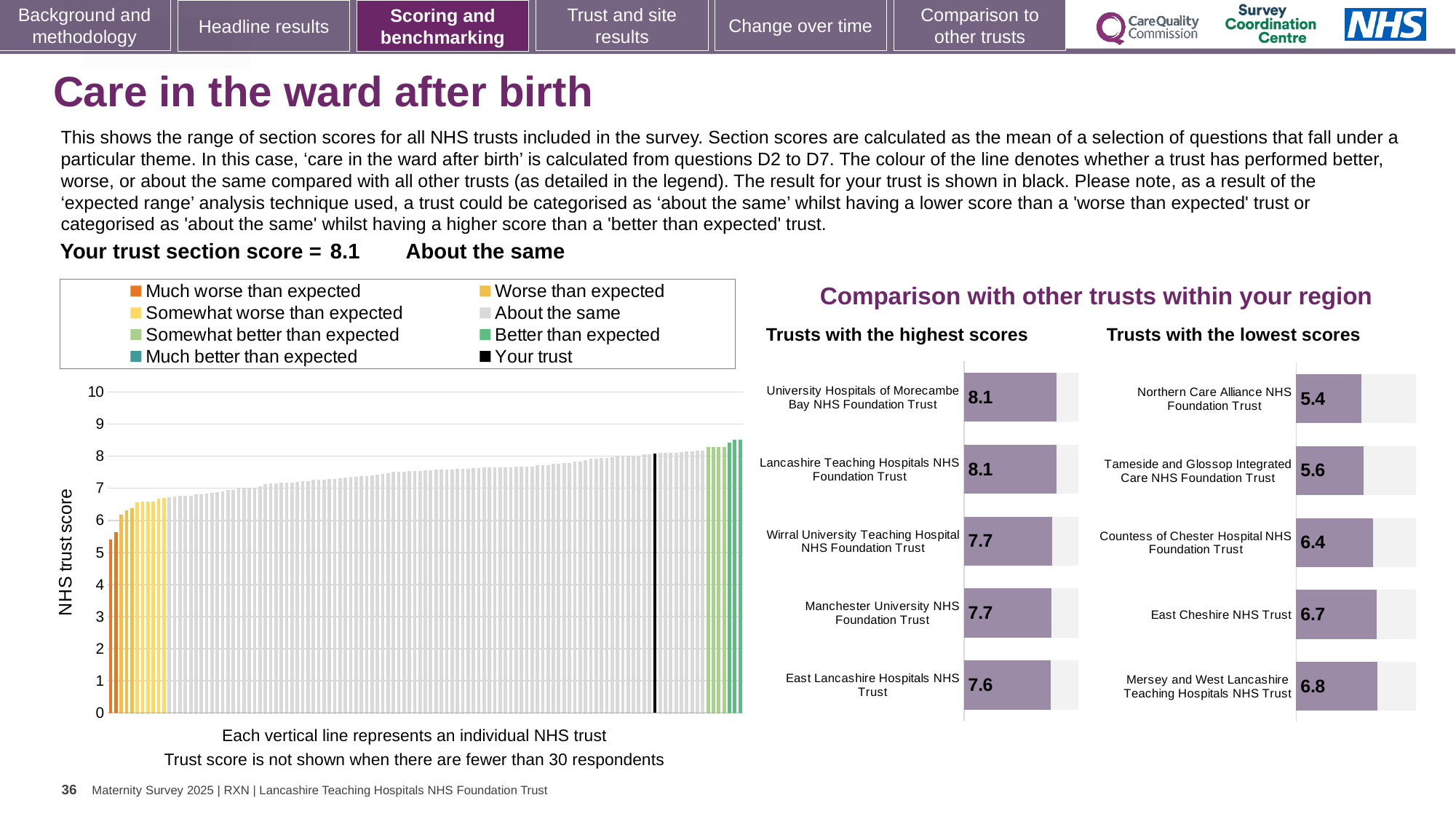
How many trusts are shown in the 'Trusts with the highest scores' chart? 5 In the 'Trusts with the highest scores' chart, what is the score for Wirral University Teaching Hospital NHS Foundation Trust? 7.7 In the 'Trusts with the lowest scores' chart, which trust has the lowest score? Northern Care Alliance NHS Foundation Trust In the main NHS trust score chart, is the value for the black 'Your trust' bar greater or less than 7? greater How many entries does the legend of the main NHS trust score chart list? 8 What is the y-axis label of the main chart on the left? NHS trust score In the 'Trusts with the lowest scores' chart, which trust has the highest score? Mersey and West Lancashire Teaching Hospitals NHS Trust In the 'Trusts with the highest scores' chart, what is the difference between the score for University Hospitals of Morecambe Bay NHS Foundation Trust and East Lancashire Hospitals NHS Trust? 0.5 In the 'Trusts with the lowest scores' chart, what is the score for Countess of Chester Hospital NHS Foundation Trust? 6.4 What kind of chart is the 'Trusts with the lowest scores' chart? Bar chart In the 'Trusts with the lowest scores' chart, what is the difference between the scores for Mersey and West Lancashire Teaching Hospitals NHS Trust and Northern Care Alliance NHS Foundation Trust? 1.4 In the 'Trusts with the lowest scores' chart, which has the larger score: Tameside and Glossop Integrated Care NHS Foundation Trust or Countess of Chester Hospital NHS Foundation Trust? Countess of Chester Hospital NHS Foundation Trust